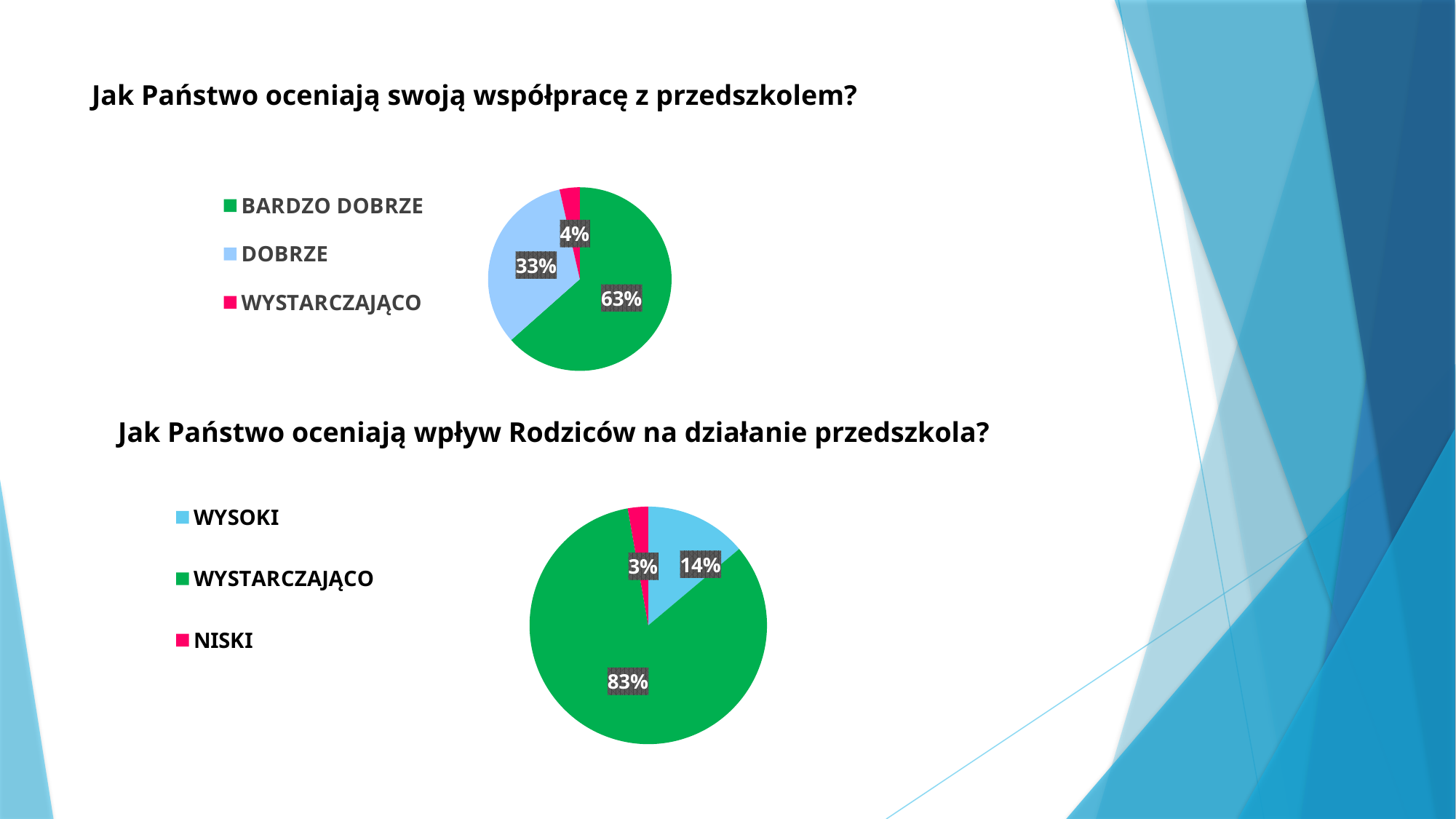
In the top chart ("Jak Państwo oceniają swoją współpracę z przedszkolem?"), what percentage is shown for BARDZO DOBRZE? 63% In the top chart ("Jak Państwo oceniają swoją współpracę z przedszkolem?"), what percentage is shown for WYSTARCZAJĄCO? 4% In the top chart ("Jak Państwo oceniają swoją współpracę z przedszkolem?"), which category has the smallest share? WYSTARCZAJĄCO In the bottom chart ("Jak Państwo oceniają wpływ Rodziców na działanie przedszkola?"), which is larger, WYSOKI or NISKI? WYSOKI What type of chart is the bottom chart ("Jak Państwo oceniają wpływ Rodziców na działanie przedszkola?")? Pie chart In the bottom chart ("Jak Państwo oceniają wpływ Rodziców na działanie przedszkola?"), what percentage is shown for NISKI? 3% In the top chart ("Jak Państwo oceniają swoją współpracę z przedszkolem?"), which category has the largest share? BARDZO DOBRZE In the top chart ("Jak Państwo oceniają swoją współpracę z przedszkolem?"), how many categories does the legend list? 3 In the top chart ("Jak Państwo oceniają swoją współpracę z przedszkolem?"), what percentage is shown for DOBRZE? 33% In the top chart ("Jak Państwo oceniają swoją współpracę z przedszkolem?"), what is the difference in percentage points between BARDZO DOBRZE and DOBRZE? 30 In the bottom chart ("Jak Państwo oceniają wpływ Rodziców na działanie przedszkola?"), what percentage is shown for WYSOKI? 14% In the bottom chart ("Jak Państwo oceniają wpływ Rodziców na działanie przedszkola?"), what percentage is shown for WYSTARCZAJĄCO? 83%